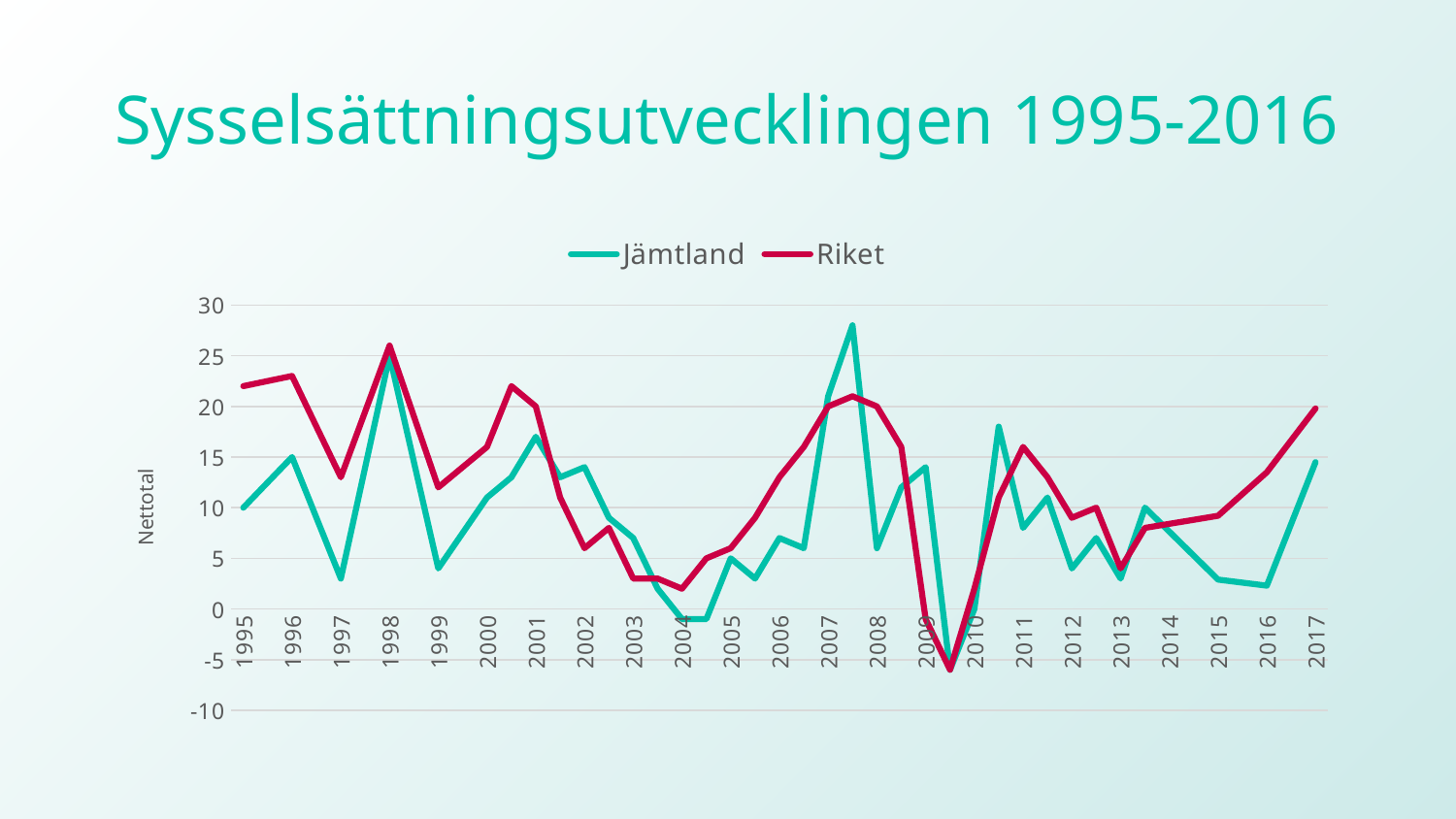
In 1995, which series has the higher value, Jämtland or Riket? Riket Does the Riket line rise or fall from 2015 to 2017? rise How many series does the legend list? 2 What kind of chart is shown on the slide? line chart Is the value for Riket in 1995 greater or less than 20? greater What is the label on the vertical axis? Nettotal What are the two series named in the legend? Jämtland and Riket Is the lowest value for Riket around 2009 greater or less than 0? less Is the value for Jämtland in 2016 greater or less than 5? less